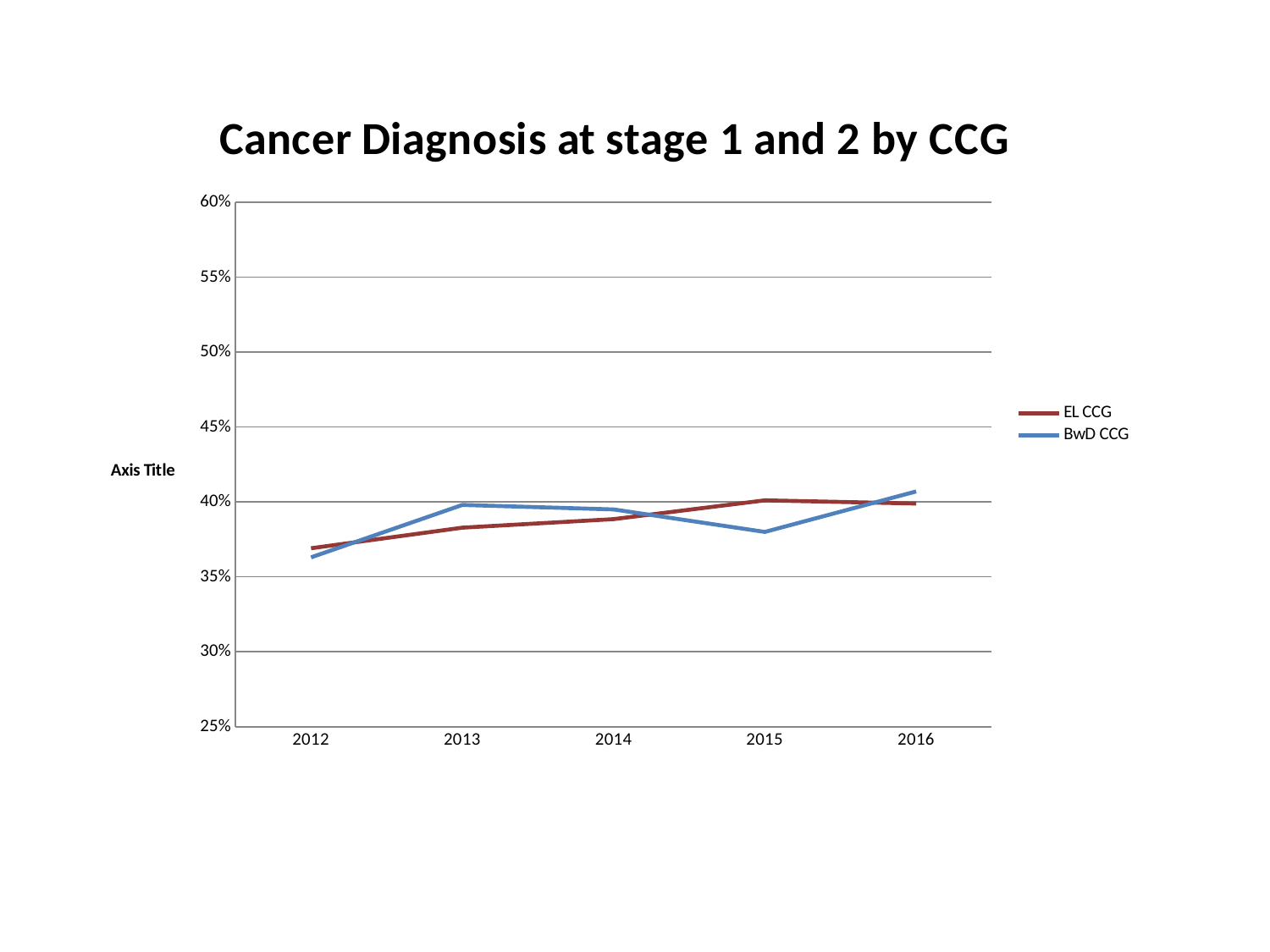
Is the value for BwD CCG in 2012 greater or less than 35%? greater Which series is drawn in blue? BwD CCG What is the title of the chart? Cancer Diagnosis at stage 1 and 2 by CCG How many series does the legend list? 2 Is the value for BwD CCG in 2015 greater or less than 40%? less In 2015, which series has the higher value, EL CCG or BwD CCG? EL CCG Does the EL CCG line generally rise or fall from 2012 to 2015? rise In 2013, which series has the higher value, EL CCG or BwD CCG? BwD CCG Is the value for EL CCG in 2012 greater or less than 40%? less What kind of chart is shown on the slide? Line chart How many years are shown on the x axis? 5 In which year is the BwD CCG value lowest? 2012